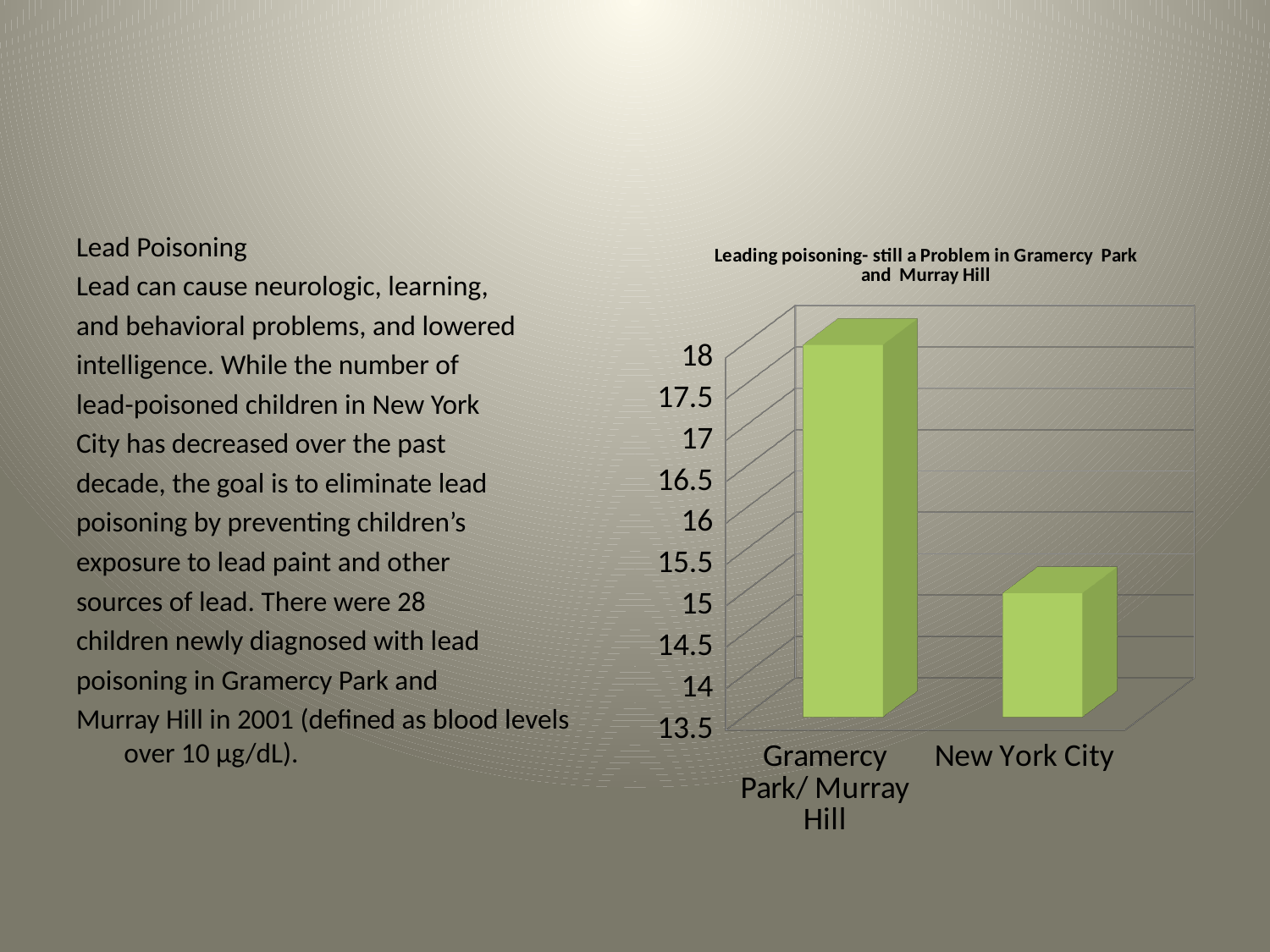
Do the bar values rise or fall from left to right along the x axis? fall Is the value for Gramercy Park/ Murray Hill greater or less than 17? greater What is the title of the chart? Leading poisoning- still a Problem in Gramercy Park and Murray Hill What kind of chart is shown on the slide? bar chart Which category has the lowest bar in the chart? New York City Is the value for New York City greater or less than 16? less How many categories are shown on the x axis of the chart? 2 Is the value for New York City greater or less than 14? greater What is the lowest value shown on the chart's vertical axis? 13.5 Which is larger, the value for Gramercy Park/ Murray Hill or the value for New York City? Gramercy Park/ Murray Hill Which category has the highest bar in the chart? Gramercy Park/ Murray Hill